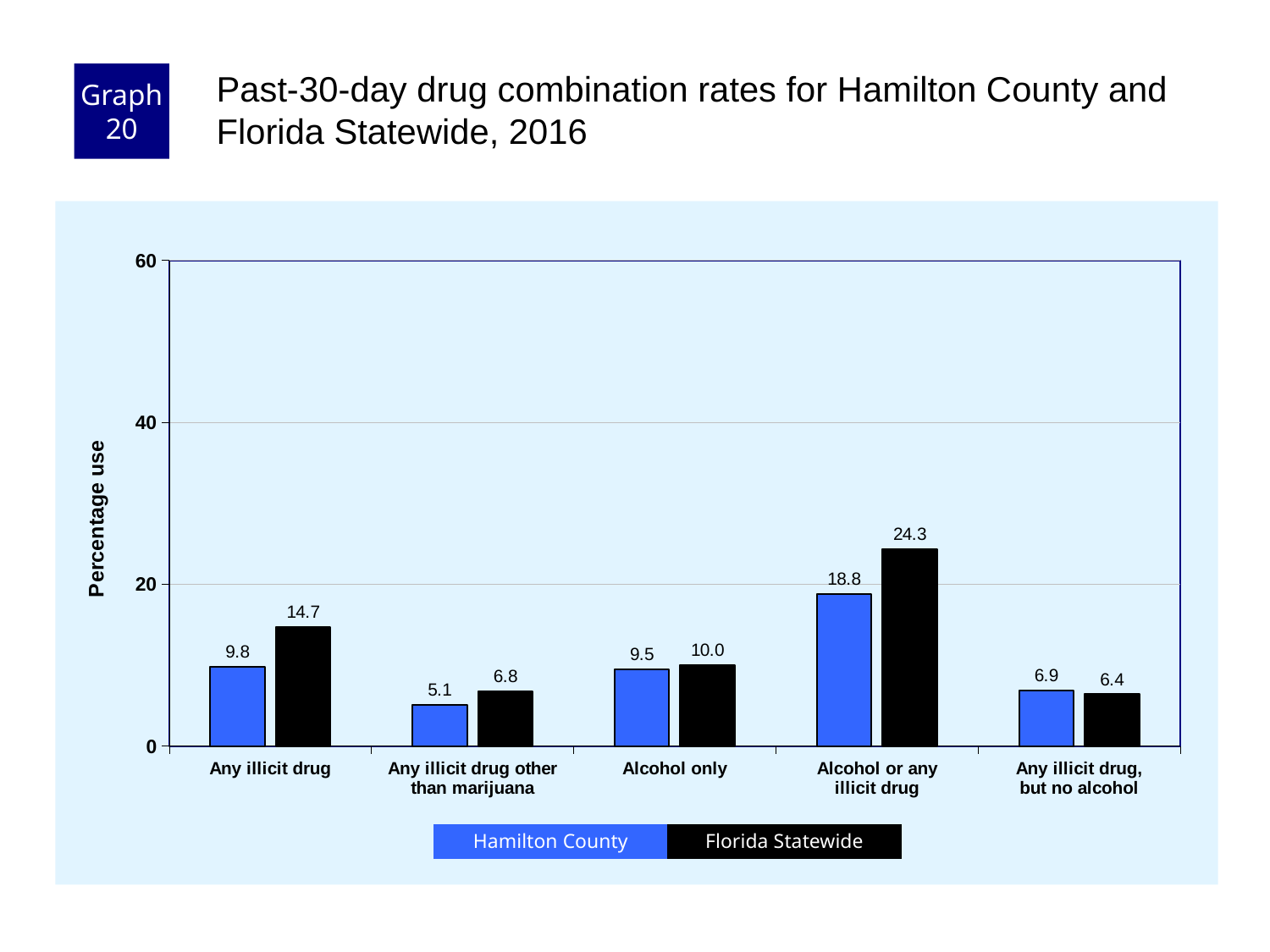
What is the difference between the Florida Statewide and Hamilton County values for Any illicit drug? 4.9 How many series does the legend list? 2 What is the Hamilton County value for Any illicit drug? 9.8 Which category has the lowest Florida Statewide value? Any illicit drug, but no alcohol What kind of chart is shown on the slide? bar chart What is the Florida Statewide value for Alcohol only? 10.0 Which category has the highest Hamilton County value? Alcohol or any illicit drug What is the Florida Statewide value for Alcohol or any illicit drug? 24.3 Is the Florida Statewide value for Alcohol or any illicit drug greater or less than 20? greater What is the difference between the Florida Statewide and Hamilton County values for Alcohol or any illicit drug? 5.5 How many categories are shown on the x axis? 5 For Any illicit drug, but no alcohol, which is larger: Hamilton County or Florida Statewide? Hamilton County